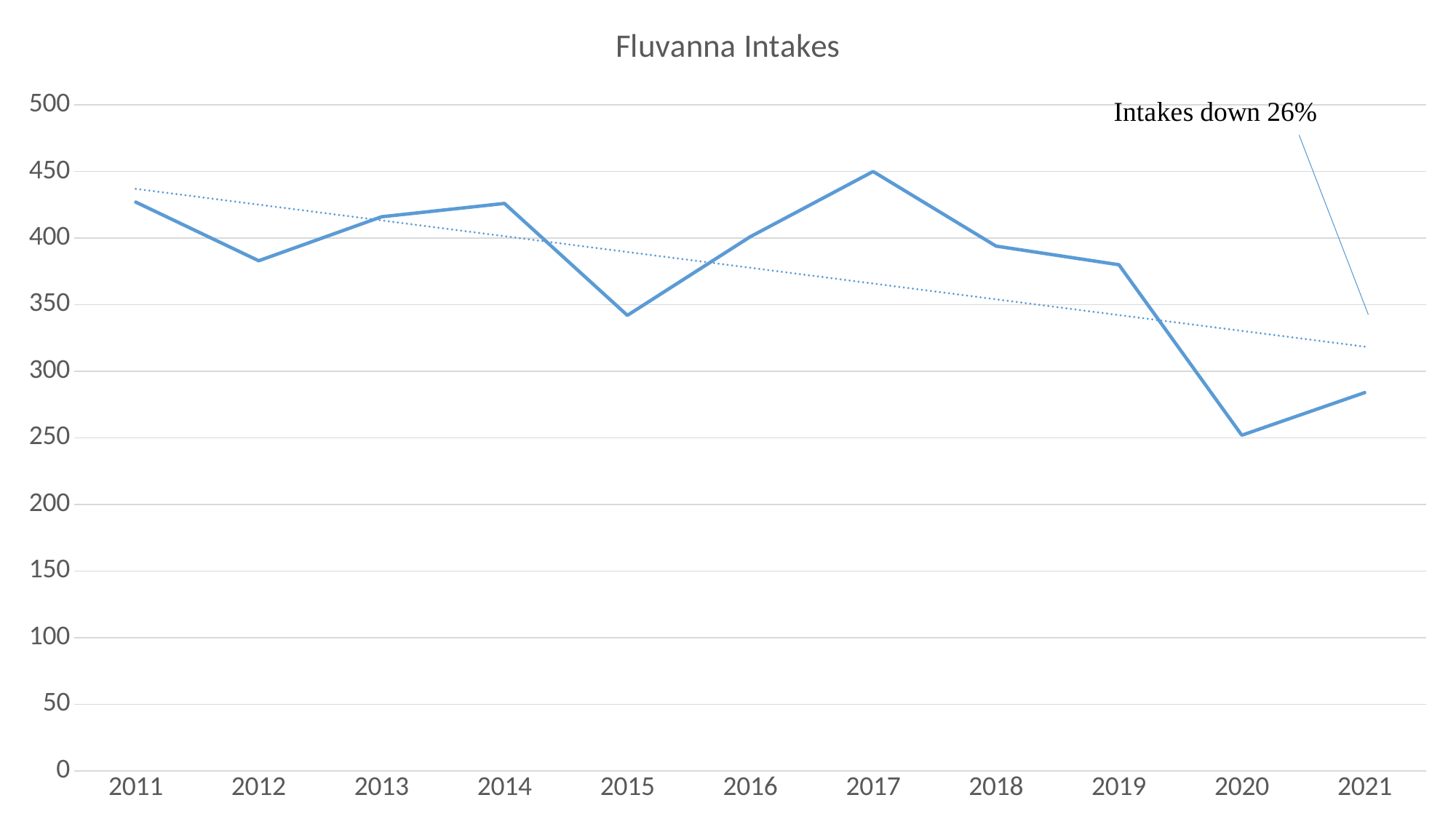
What is the title of the chart? Fluvanna Intakes How many years are plotted along the x axis? 11 Is the value for 2021 greater or less than 300? less What kind of chart is shown on the slide? line chart Is the value for 2011 greater or less than 400? greater Which year has more intakes, 2014 or 2015? 2014 Is the value for 2020 greater or less than 300? less Which year has the lowest number of intakes? 2020 Which year has the highest number of intakes? 2017 Overall, do intakes rise or fall from 2011 to 2021? fall What does the annotation on the chart say? Intakes down 26%